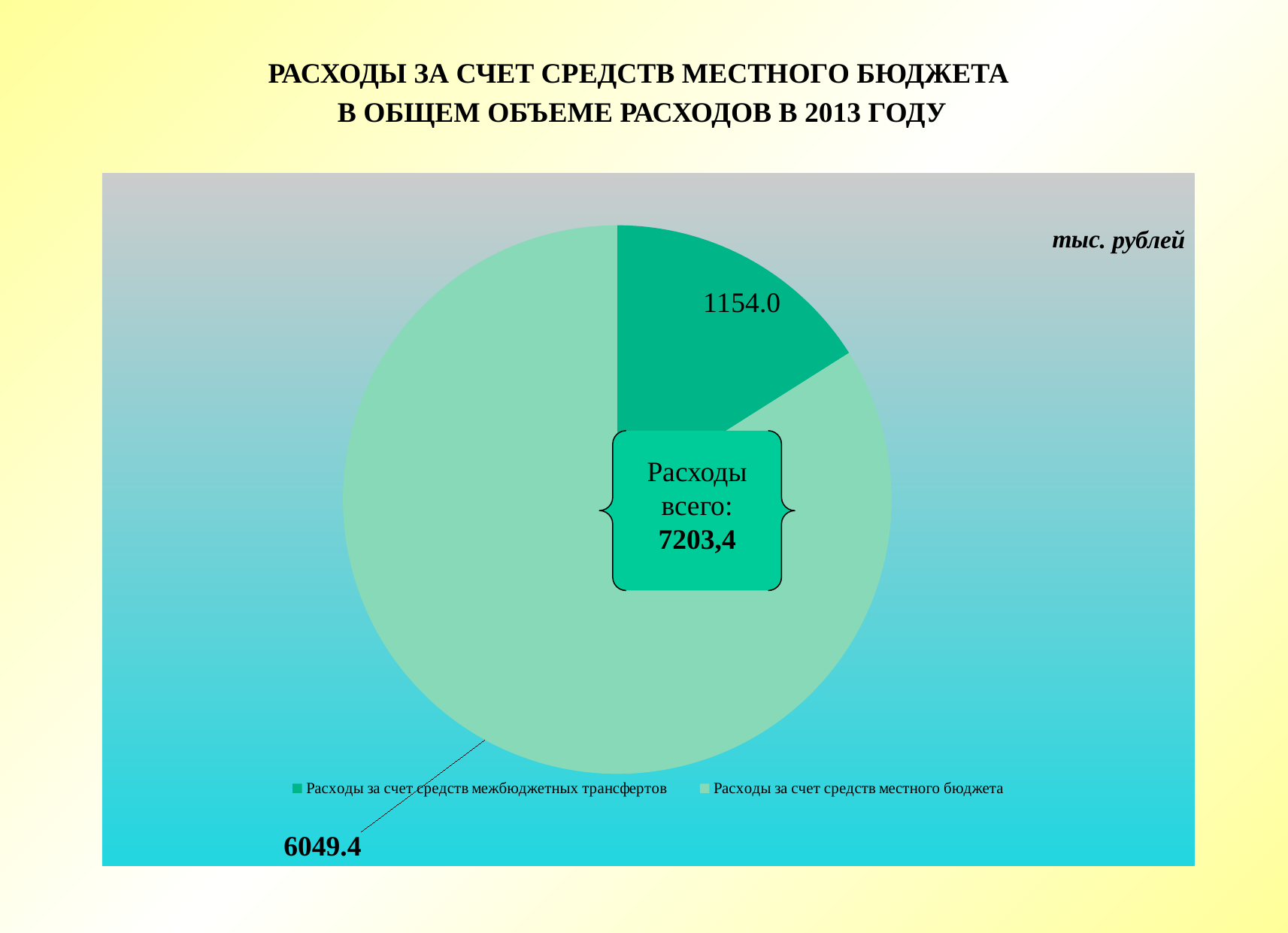
What kind of chart is shown on the slide? pie chart What is the value for "Расходы за счет средств местного бюджета"? 6049.4 What is the difference between the value for "Расходы за счет средств местного бюджета" and the value for "Расходы за счет средств межбюджетных трансфертов"? 4895.4 Which category has the largest slice of the pie? Расходы за счет средств местного бюджета What is the total of all expenses shown in the chart (Расходы всего)? 7203,4 Which year does the chart title refer to? 2013 How many slices does the pie chart have? 2 Which category has the smallest slice of the pie? Расходы за счет средств межбюджетных трансфертов Which is larger: expenses from local budget funds or expenses from inter-budget transfers? Расходы за счет средств местного бюджета In what units are the values on the chart given? тыс. рублей What is the value for "Расходы за счет средств межбюджетных трансфертов"? 1154.0 How many entries does the legend list? 2